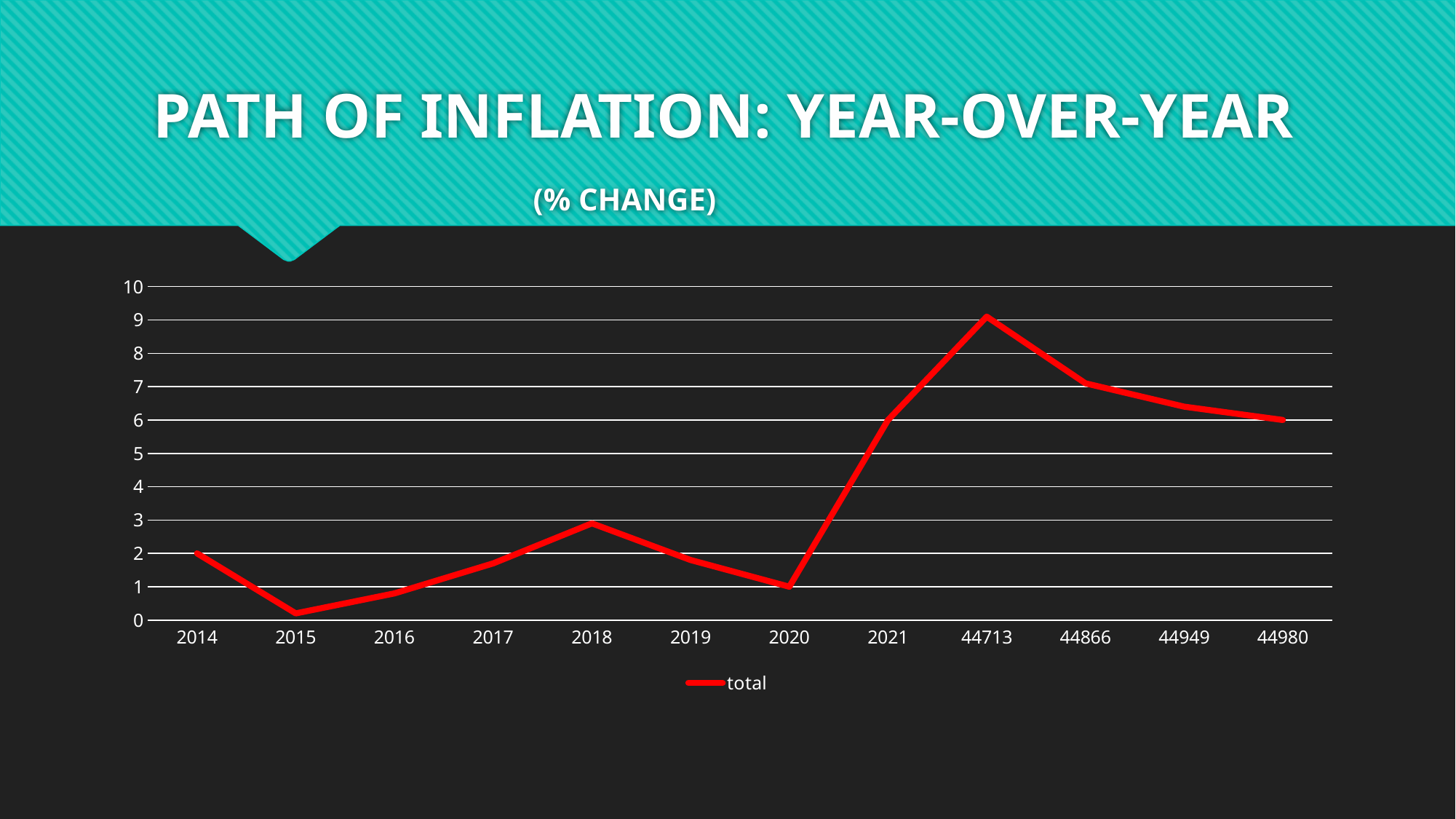
Is the value for 44713 greater or less than 8? greater What is the name of the series shown in the legend? total How many data points are plotted along the x axis? 12 Which category has the lowest value on the chart? 2015 Is the value for 2020 greater or less than 2? less Is the value for 2015 greater or less than 1? less Which is larger, the value for 2018 or the value for 2019? 2018 Do the values rise or fall from 44713 to 44980? fall How many series does the legend list? 1 What kind of chart is shown on the slide? line chart Which category has the highest value on the chart? 44713